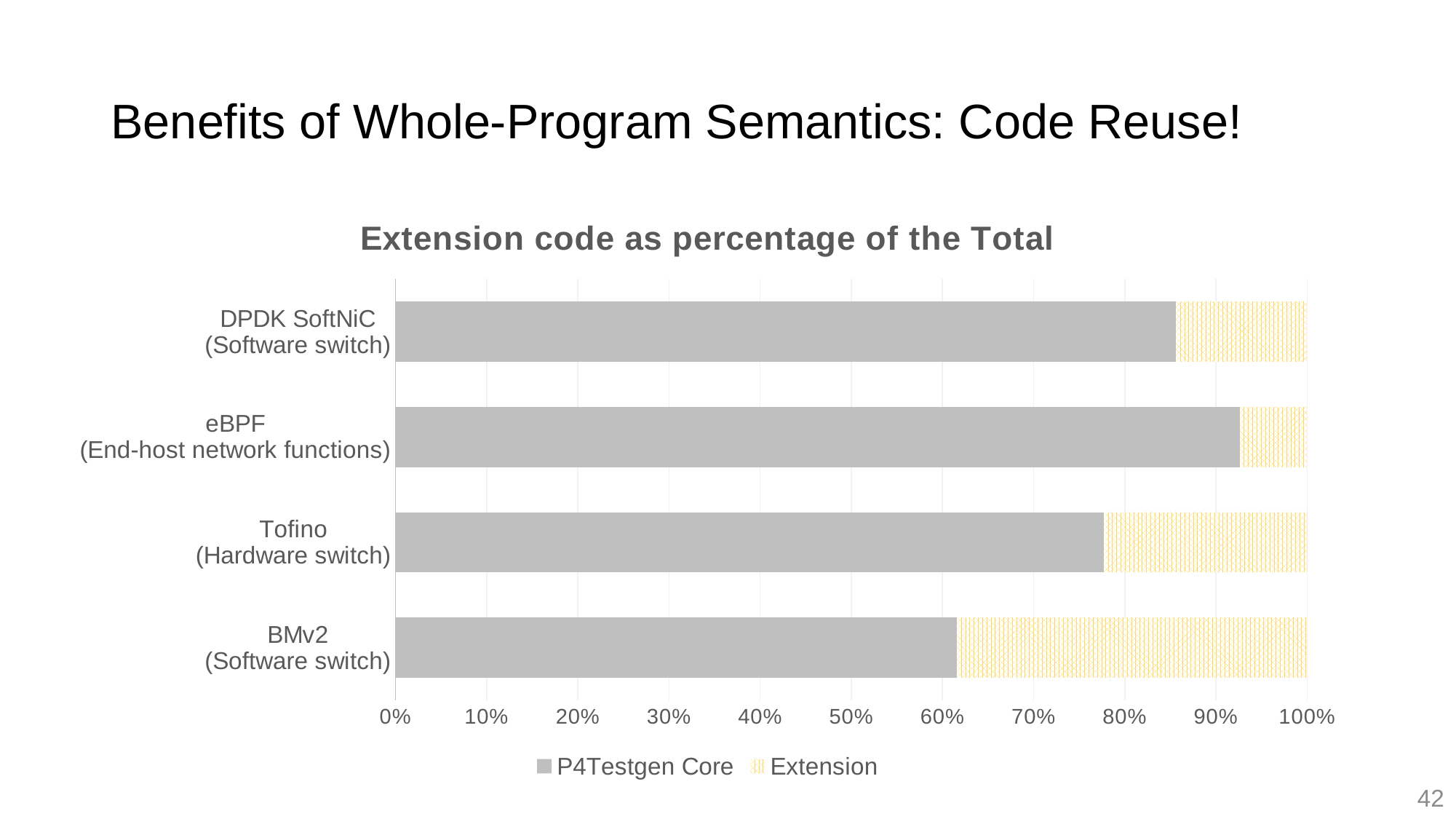
How many categories (targets) are shown on the chart? 4 Which has a larger P4Testgen Core share, DPDK SoftNiC (Software switch) or Tofino (Hardware switch)? DPDK SoftNiC (Software switch) Which category has the smallest P4Testgen Core share? BMv2 (Software switch) Is the P4Testgen Core value for BMv2 (Software switch) greater or less than 70%? less Which legend entry is drawn with a yellow hatched pattern? Extension Is the P4Testgen Core value for Tofino (Hardware switch) greater or less than 70%? greater How many series does the legend list? 2 Is the P4Testgen Core value for eBPF (End-host network functions) greater or less than 90%? greater Which category has the largest Extension share? BMv2 (Software switch) What is the title of the chart? Extension code as percentage of the Total Which category has the largest P4Testgen Core share? eBPF (End-host network functions) What kind of chart is shown on the slide? bar chart